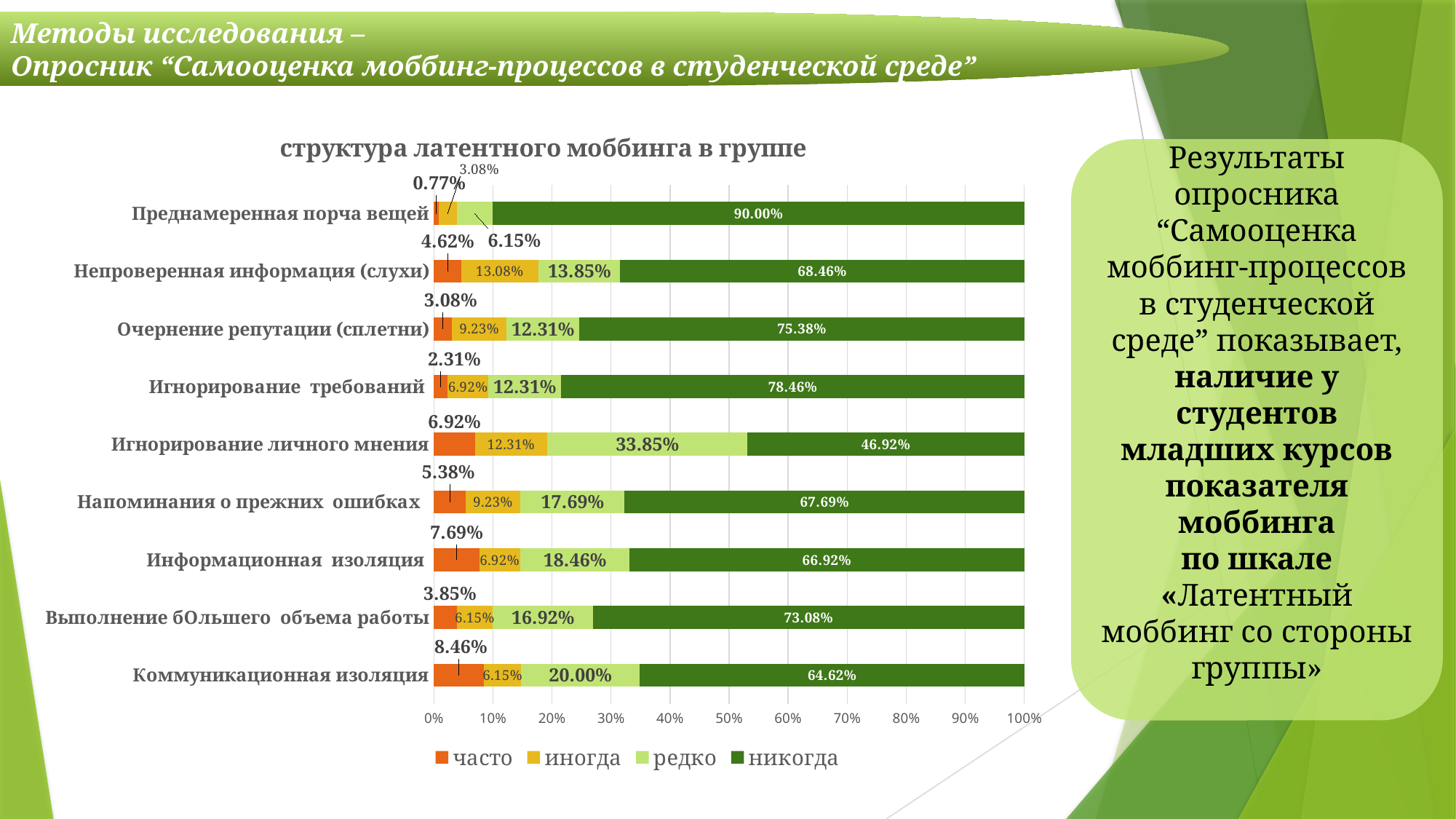
Which category has the highest value for 'редко'? Игнорирование личного мнения What is the value of 'редко' for 'Игнорирование личного мнения'? 33.85% What is the title of the chart? структура латентного моббинга в группе How many categories are plotted on the chart? 9 What is the value of 'иногда' for 'Непроверенная информация (слухи)'? 13.08% What is the difference between the 'никогда' values for 'Очернение репутации (сплетни)' and 'Игнорирование требований'? 3.08% How many series does the chart legend list? 4 What kind of chart is shown on the slide? Stacked bar chart Which category has the lowest value for 'никогда'? Игнорирование личного мнения What is the value of 'часто' for 'Коммуникационная изоляция'? 8.46% Which is larger: the 'часто' value for 'Информационная изоляция' or for 'Напоминания о прежних ошибках'? Информационная изоляция What is the value of 'никогда' for 'Преднамеренная порча вещей'? 90.00%